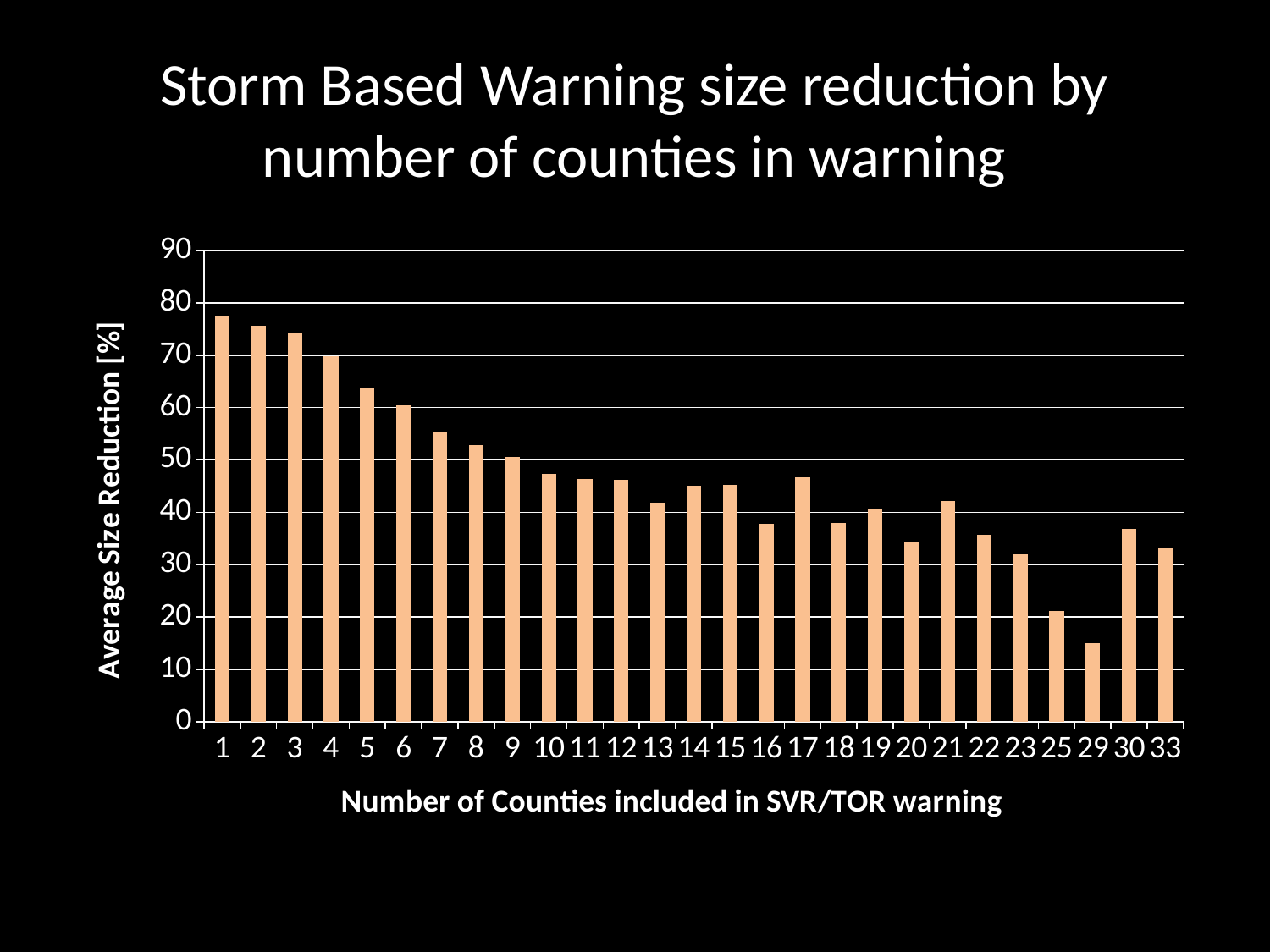
How many bars (categories) are plotted on the chart? 27 Is the value for 29 counties greater or less than 20? less Is the value for 1 county greater or less than 70? greater What is the label of the vertical axis? Average Size Reduction [%] Which number of counties has the highest average size reduction? 1 What kind of chart is shown on the slide? bar chart Which has a larger average size reduction, 16 counties or 17 counties? 17 counties Is the value for 16 counties greater or less than 40? less Which has a larger average size reduction, 3 counties or 6 counties? 3 counties Which number of counties has the lowest average size reduction? 29 Do the values generally rise or fall as the number of counties increases along the x axis? fall